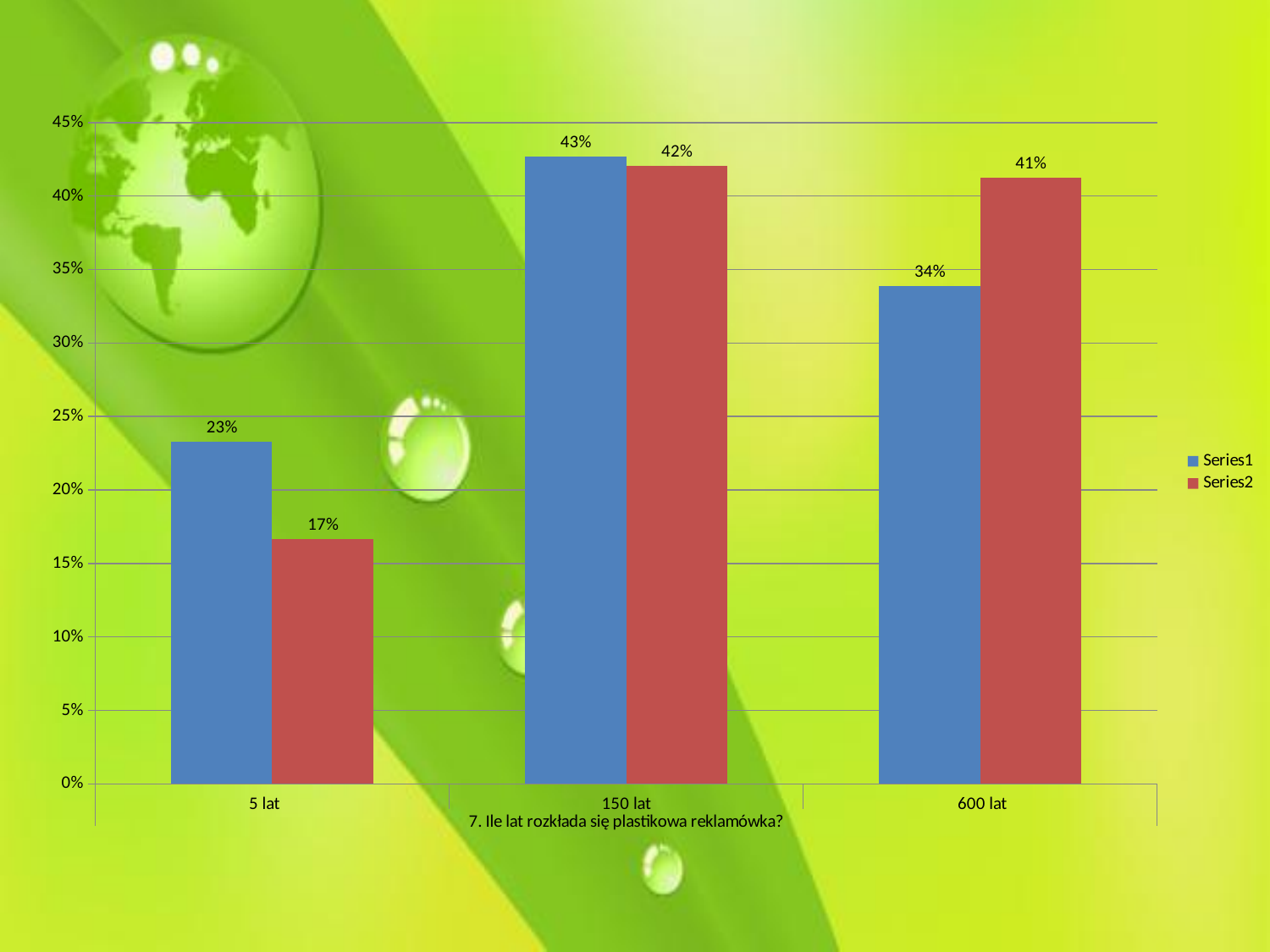
What kind of chart is shown on the slide? Bar chart Which category has the highest value for Series1? 150 lat What is the difference between Series1 and Series2 for the category "5 lat"? 6% What is the value of Series1 for the category "5 lat"? 23% Which is larger for the category "600 lat": Series1 or Series2? Series2 What is the value of Series2 for the category "150 lat"? 42% What is the value of Series2 for the category "600 lat"? 41% What colour are the Series2 bars? Red How many categories are shown on the x axis? 3 What is the x-axis title of the chart? 7. Ile lat rozkłada się plastikowa reklamówka? Which category has the lowest value for Series2? 5 lat How many series does the legend list? 2